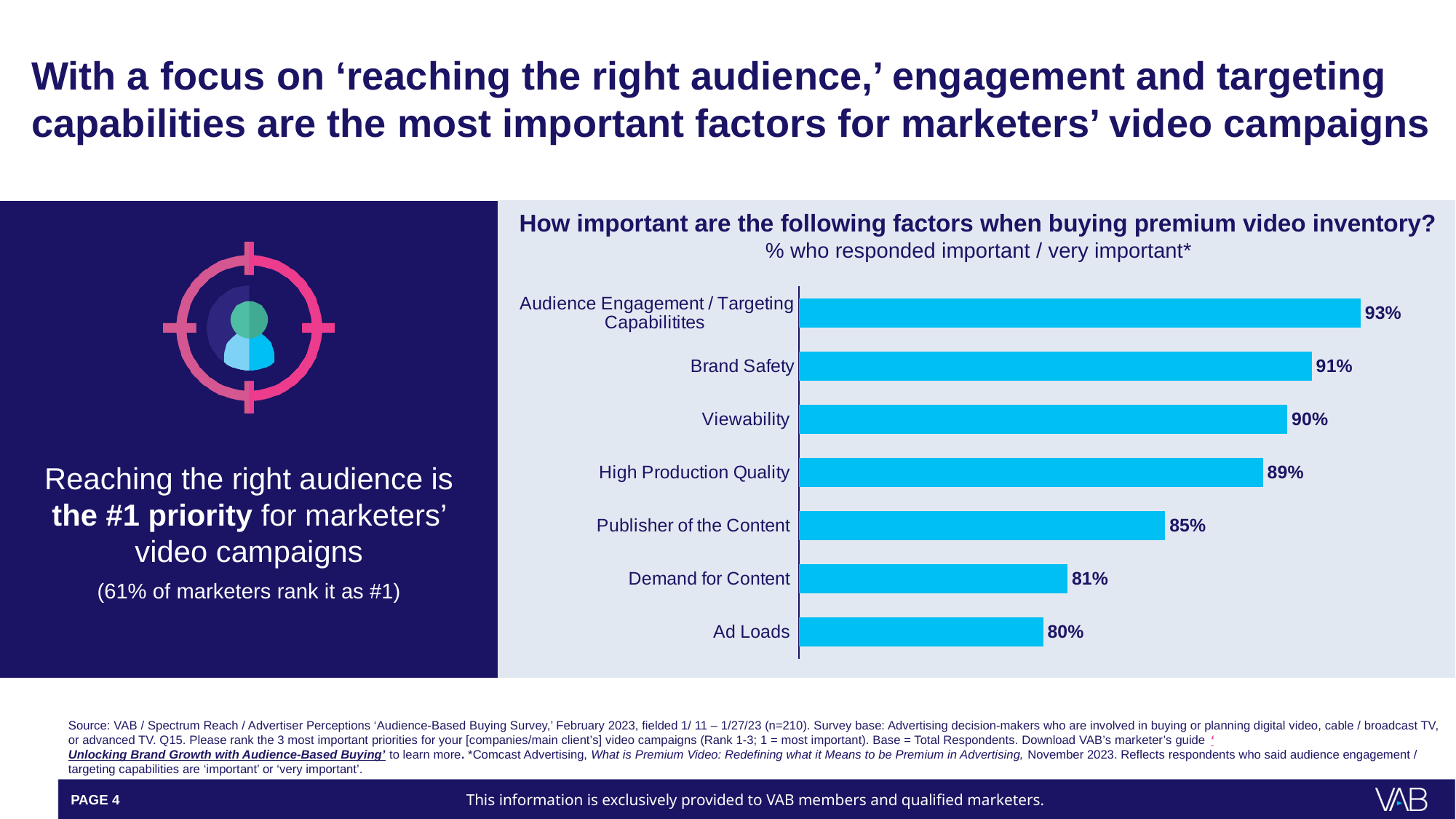
Which factor has the highest percentage in the chart? Audience Engagement / Targeting Capabilitites What is the value shown for Publisher of the Content? 85% Which has a higher value, High Production Quality or Publisher of the Content? High Production Quality What is the difference in percentage points between Viewability and Demand for Content? 9 What percentage of respondents rated Audience Engagement / Targeting Capabilities as important or very important? 93% Which factor has the lowest percentage in the chart? Ad Loads What is the value shown for Brand Safety? 91% What is the difference in percentage points between Audience Engagement / Targeting Capabilities and Ad Loads? 13 How many factors are shown in the chart? 7 What type of chart is shown on the slide? Bar chart What is the title of the chart? How important are the following factors when buying premium video inventory? What is the value shown for Ad Loads? 80%